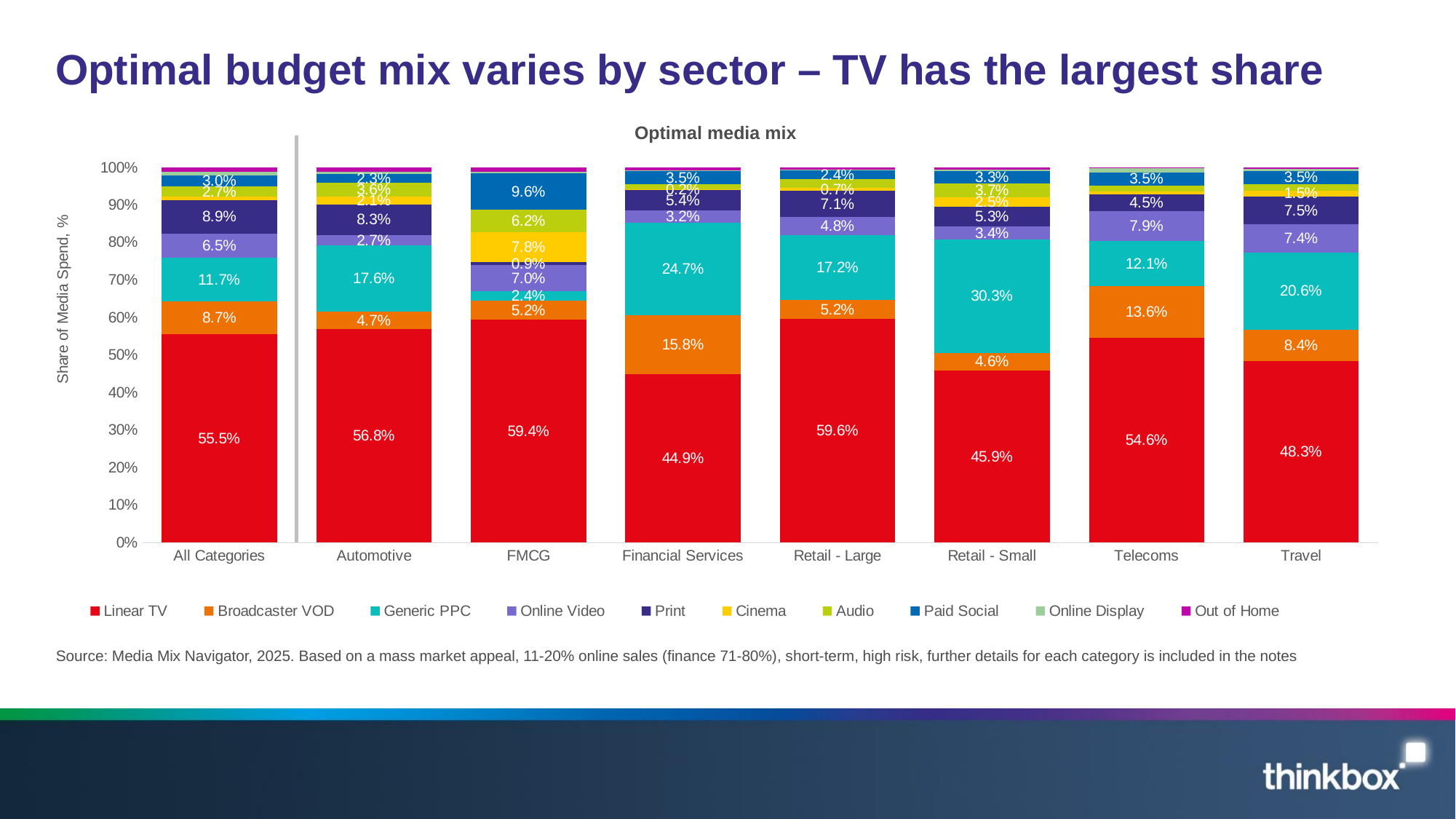
How many series does the legend of the Optimal media mix chart list? 10 What is the difference between the Broadcaster VOD share for Telecoms and for Automotive? 8.9 percentage points Is the Linear TV share for Retail - Small greater or less than 50%? less What kind of chart is shown on the slide? Stacked bar chart What is the Broadcaster VOD share for Financial Services? 15.8% What is the Linear TV share for Telecoms? 54.6% What is the Generic PPC share for Financial Services? 24.7% Which sector has the highest Generic PPC share? Retail - Small What is the title of the y axis on the chart? Share of Media Spend, % Which has the larger Linear TV share, Travel or Financial Services? Travel What is the Paid Social share for FMCG? 9.6% How many sector categories are shown along the x axis of the Optimal media mix chart? 8